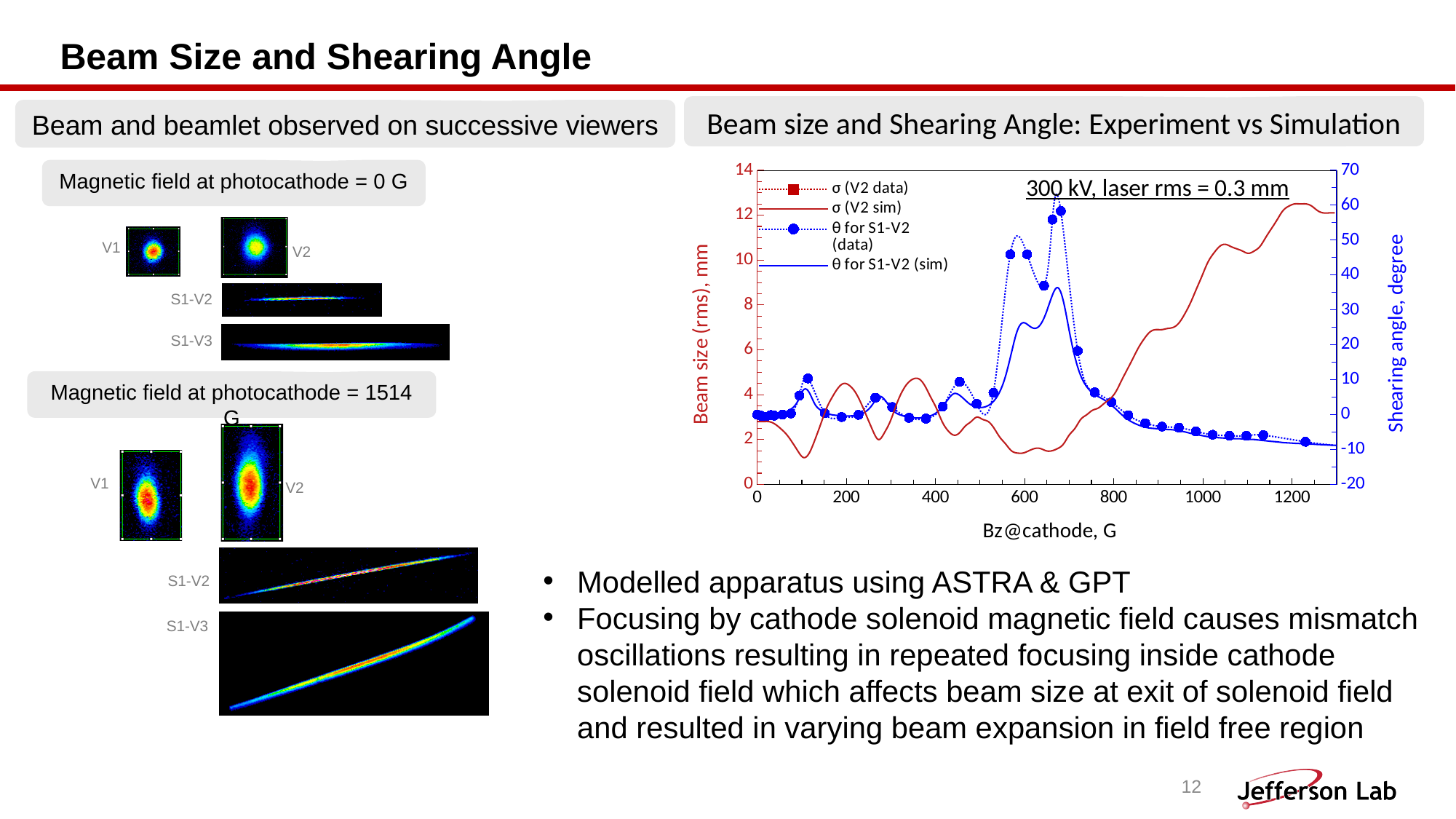
Does σ (V2 sim) rise or fall as Bz increases from 800 G to 1200 G? rise What is the title of the right-hand y-axis of the chart? Shearing angle, degree What kind of chart is shown on the slide? line chart Is the value of σ (V2 sim) at Bz = 0 G greater or less than 4 mm? less Is the value of θ for S1-V2 (data) at Bz = 1200 G greater or less than 0 degrees? less Does θ for S1-V2 (data) rise or fall as Bz increases from 700 G to 1200 G? fall Is the value of σ (V2 sim) at Bz = 1000 G greater or less than 8 mm? greater What is the x-axis title of the chart? Bz@cathode, G How many series does the chart legend list? 4